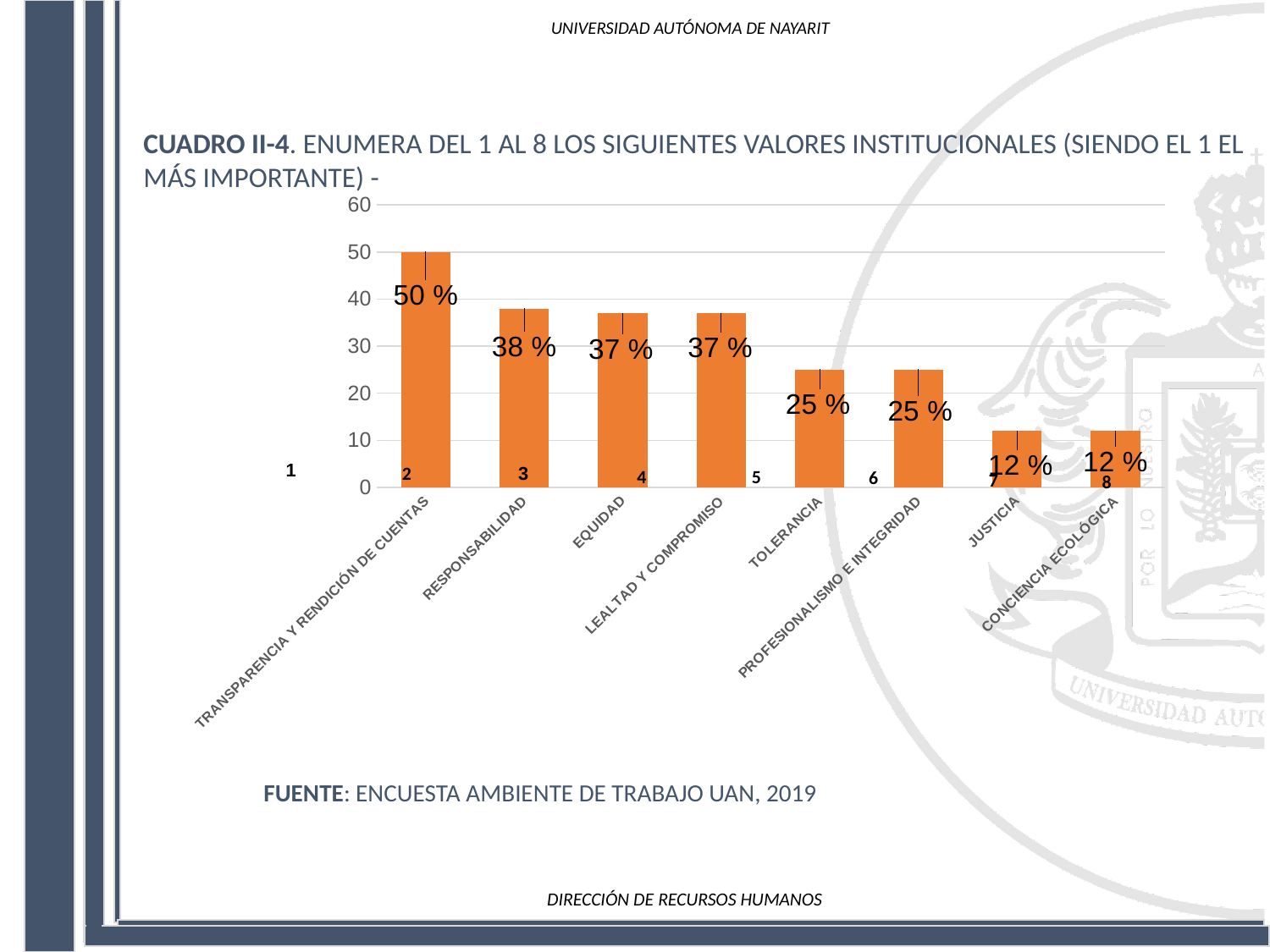
What source is cited below the chart? ENCUESTA AMBIENTE DE TRABAJO UAN, 2019 Do the values rise or fall from left to right along the x axis? fall What is the difference between the values for EQUIDAD and JUSTICIA? 25 % Which category has the highest value? TRANSPARENCIA Y RENDICIÓN DE CUENTAS What is the value for TRANSPARENCIA Y RENDICIÓN DE CUENTAS? 50 % How many categories are plotted in the chart? 8 What is the value for RESPONSABILIDAD? 38 % Which is larger, the value for LEALTAD Y COMPROMISO or the value for PROFESIONALISMO E INTEGRIDAD? LEALTAD Y COMPROMISO What is the difference between the values for TRANSPARENCIA Y RENDICIÓN DE CUENTAS and RESPONSABILIDAD? 12 % What type of chart is shown on the slide? bar chart What is the value for TOLERANCIA? 25 % What is the value for CONCIENCIA ECOLÓGICA? 12 %